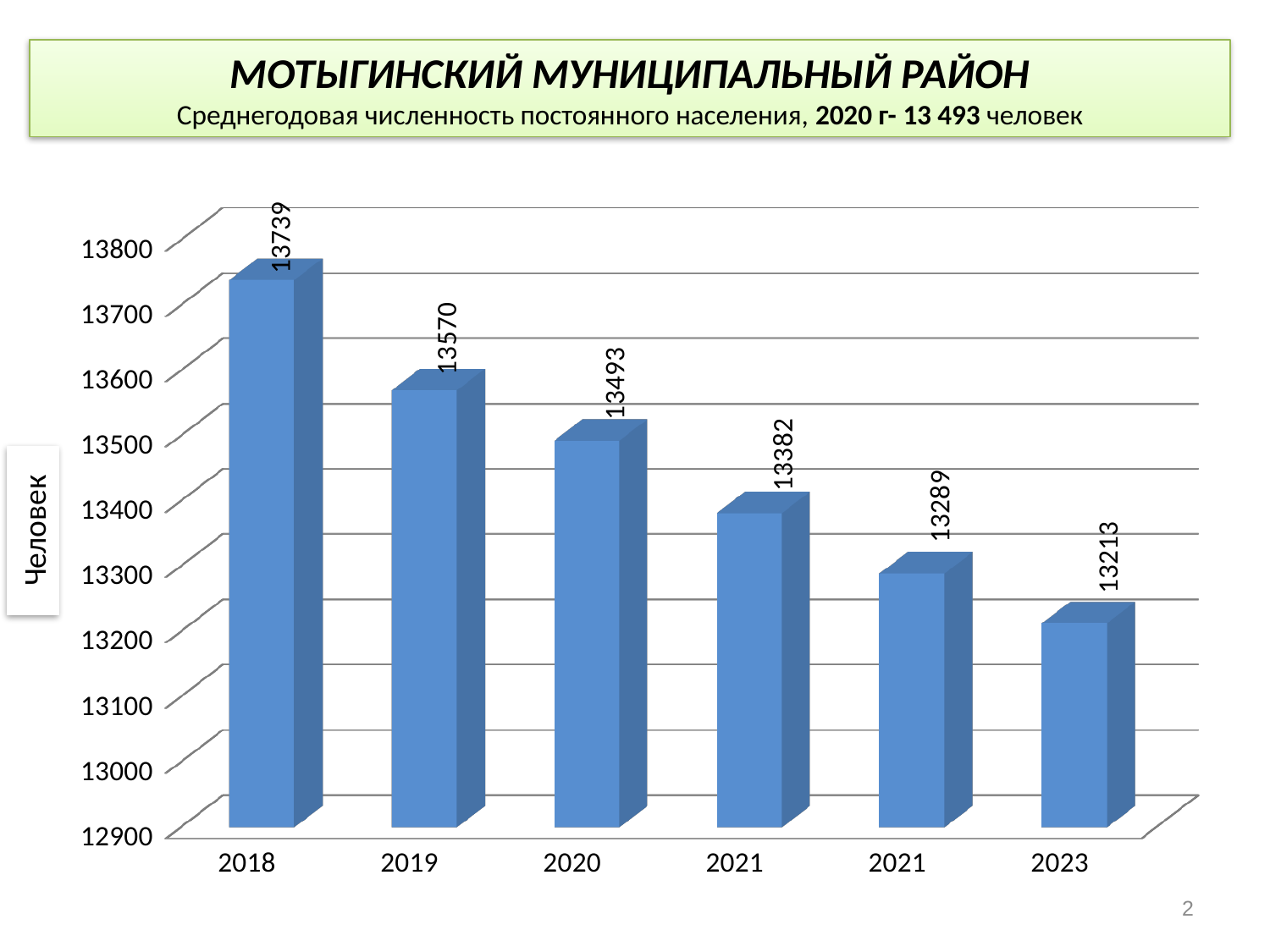
What is the value shown for 2019? 13570 What is the value shown for 2018? 13739 How many bars are shown in the chart? 6 Which year has the highest value? 2018 Do the values rise or fall from left to right along the x axis? fall Which is larger, the value for 2019 or the value for 2020? 2019 What is the value shown for 2023? 13213 Which year has the lowest value? 2023 What kind of chart is shown on the slide? bar chart What is the value shown on the fifth bar from the left? 13289 What is the difference between the values for 2018 and 2023? 526 What is the value shown for 2020? 13493